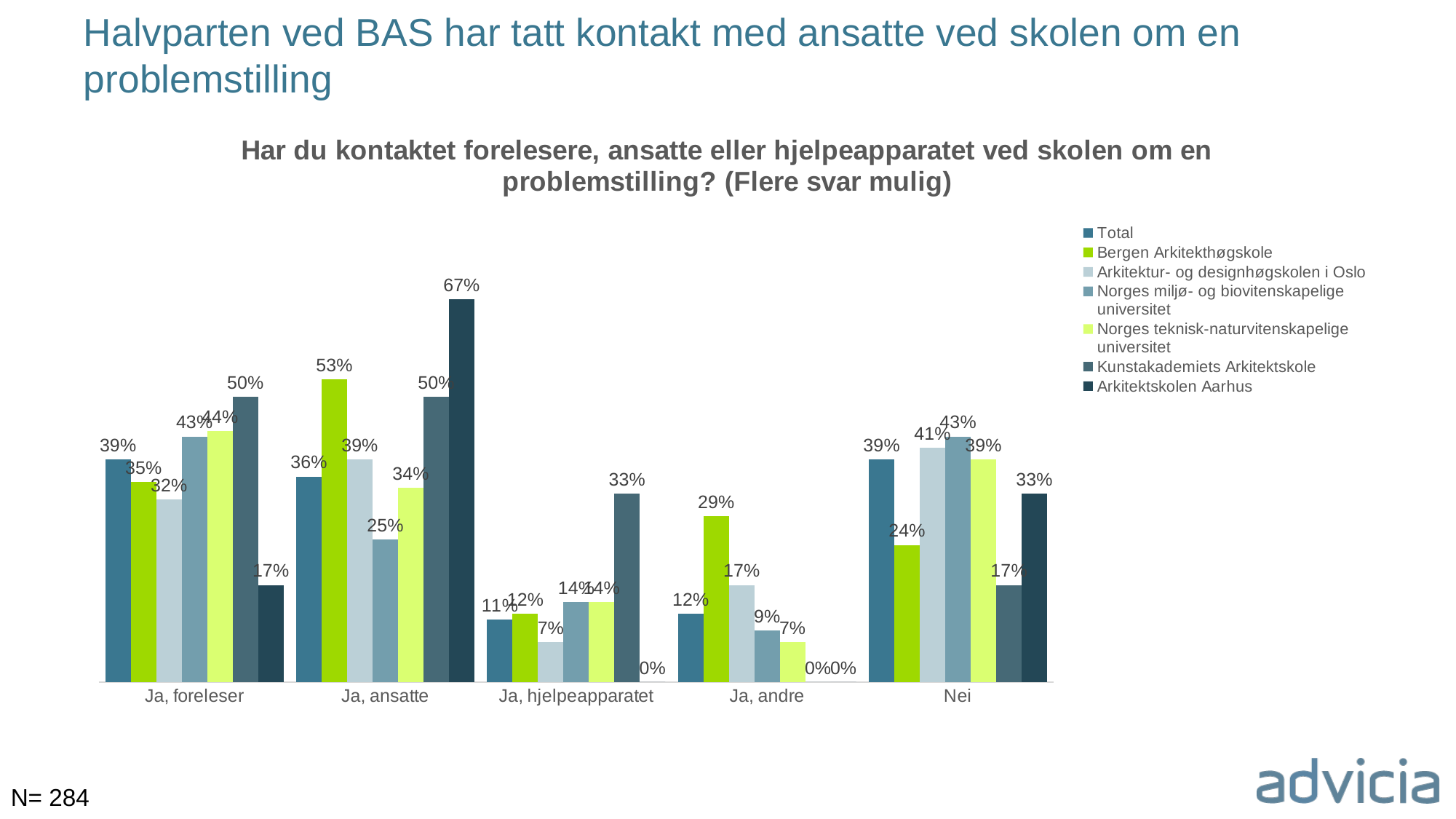
How many series does the legend list? 7 What is the sample size (N) shown on the slide? 284 What is the value for Bergen Arkitekthøgskole in the 'Ja, ansatte' category? 53% What is the Total value for 'Nei'? 39% In the 'Ja, andre' category, which is larger: Bergen Arkitekthøgskole or Arkitektur- og designhøgskolen i Oslo? Bergen Arkitekthøgskole Which series has the highest value in the 'Ja, ansatte' category? Arkitektskolen Aarhus How many categories are shown on the x axis? 5 Which series has the lowest value in the 'Nei' category? Kunstakademiets Arkitektskole What is the difference between Arkitektskolen Aarhus and Total in the 'Ja, ansatte' category? 31 percentage points What kind of chart is shown on the slide? Bar chart What is the value for Arkitektskolen Aarhus in the 'Ja, foreleser' category? 17% What is the value for Kunstakademiets Arkitektskole in the 'Ja, hjelpeapparatet' category? 33%